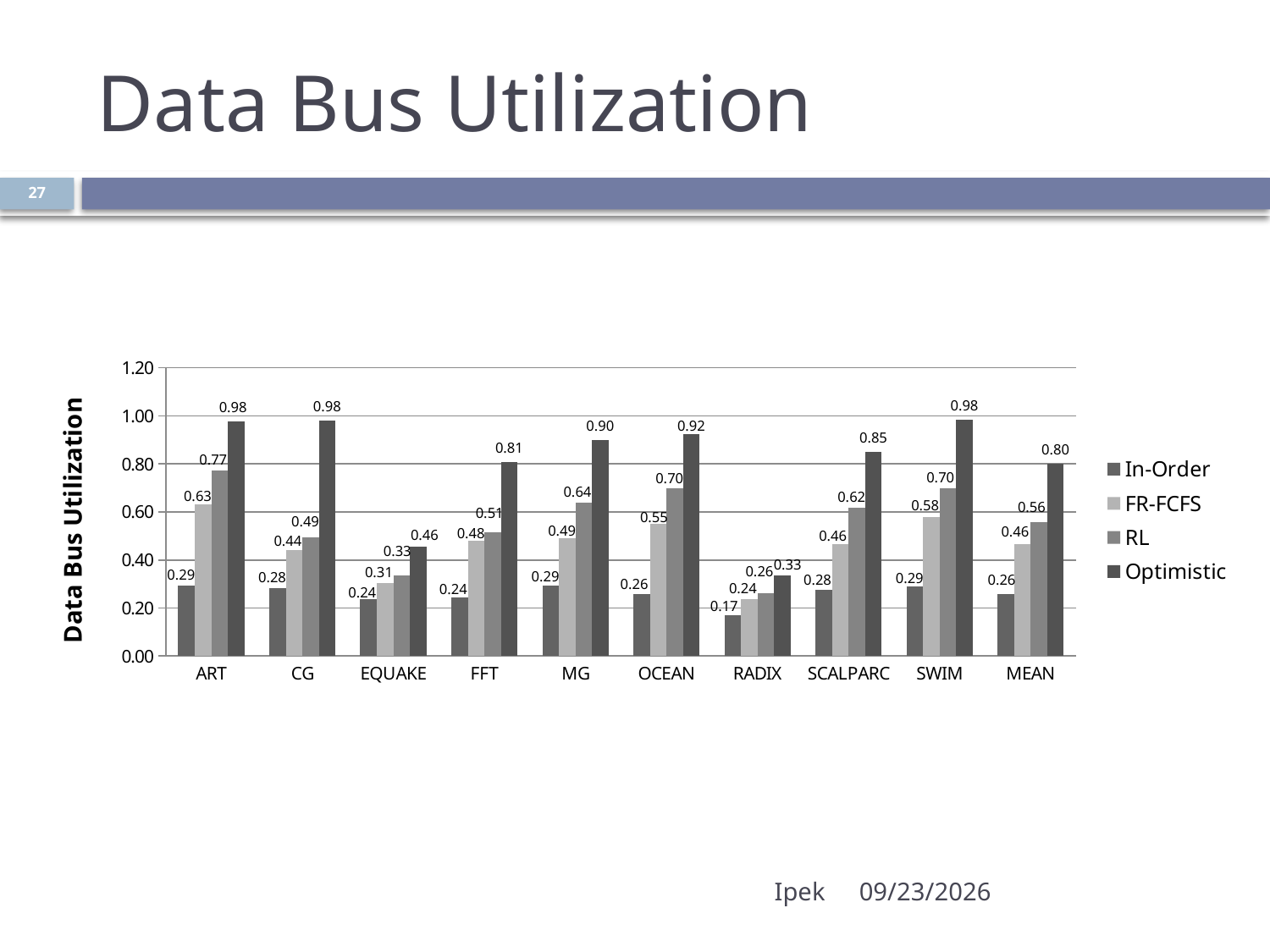
What is the difference between the Optimistic and In-Order values for SWIM? 0.69 What kind of chart is shown on the slide? Bar chart How many categories are shown on the x axis? 10 What is the Optimistic value for MEAN? 0.80 Which category has the highest RL value? ART Which is larger for MG: the FR-FCFS value or the RL value? RL How many series does the legend list? 4 What is the In-Order value for RADIX? 0.17 What is the FR-FCFS value for SCALPARC? 0.46 What is the label of the y axis? Data Bus Utilization Which category has the lowest Optimistic value? RADIX What is the RL value for OCEAN? 0.70